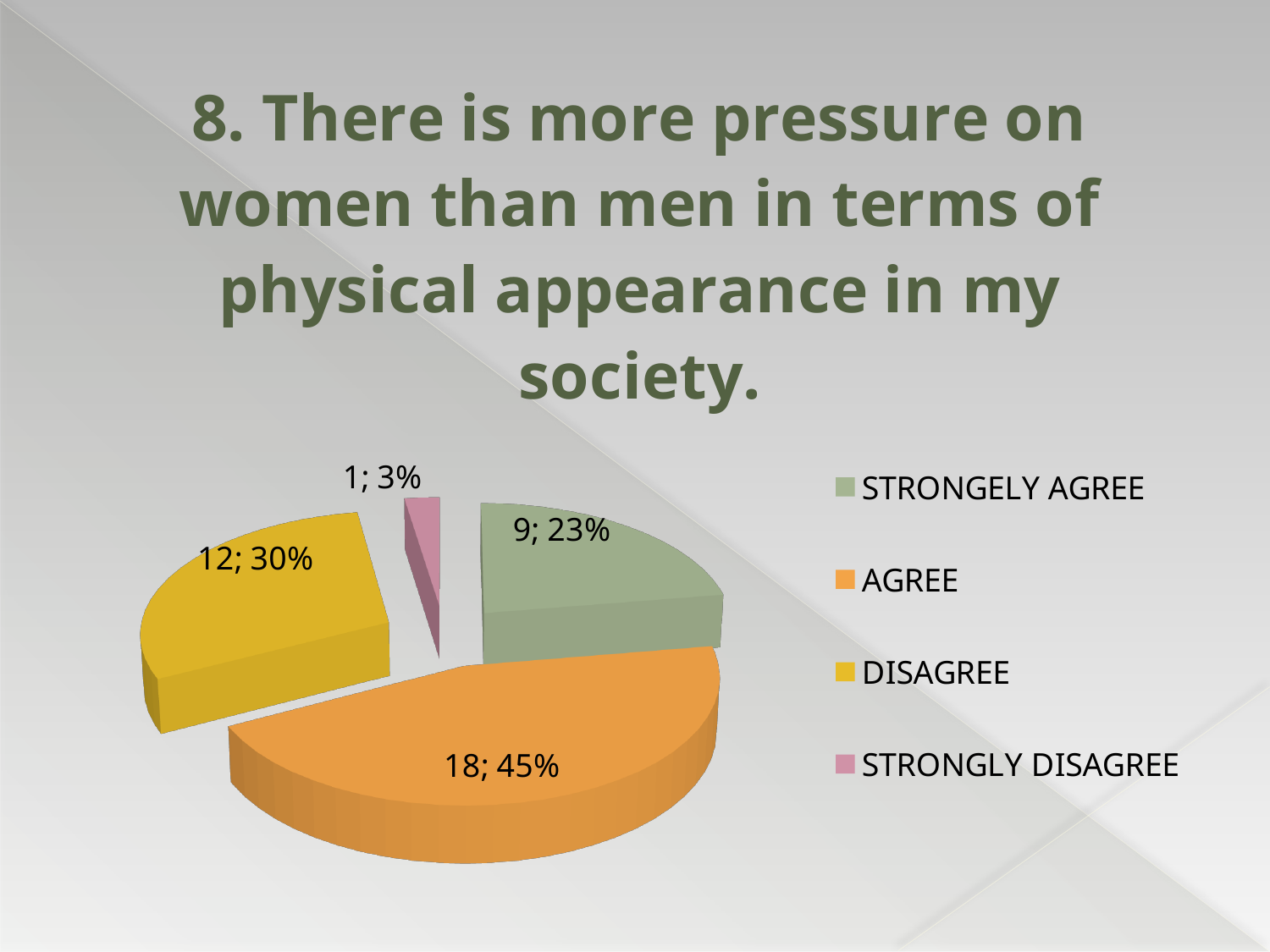
Which category has the smallest slice? STRONGLY DISAGREE Which category has the largest slice? AGREE How many entries does the legend list? 4 Which has more respondents, STRONGLY AGREE or DISAGREE? DISAGREE What colour is the AGREE slice? Orange How many respondents chose AGREE? 18 How many respondents chose DISAGREE? 12 How many slices does the pie chart have? 4 What share of the pie does STRONGLY DISAGREE represent? 3% What is the difference in count between AGREE and DISAGREE? 6 What kind of chart is shown on the slide? Pie chart What percentage of respondents chose STRONGLY AGREE? 23%